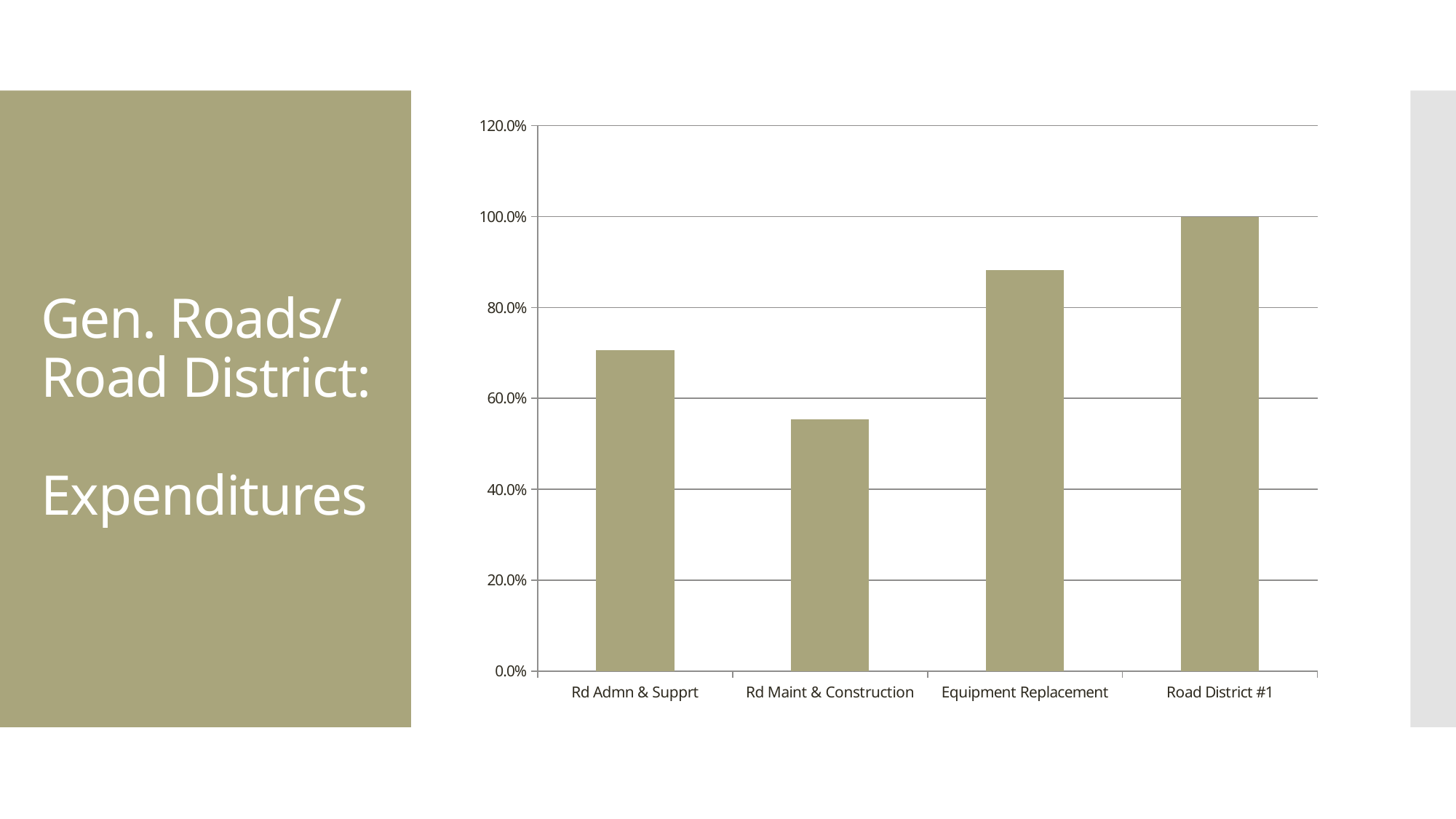
What is the highest value shown on the y axis of the chart? 120.0% How many categories are shown on the x axis of the chart? 4 Which is larger, the value for Equipment Replacement or the value for Rd Admn & Supprt? Equipment Replacement What is the value for Road District #1? 100.0% Is the value for Rd Admn & Supprt greater or less than 80.0%? less Is the value for Equipment Replacement greater or less than 80.0%? greater Which category has the highest value in the chart? Road District #1 Which category has the lowest value in the chart? Rd Maint & Construction Is the value for Rd Maint & Construction greater or less than 60.0%? less Which is larger, the value for Rd Maint & Construction or the value for Road District #1? Road District #1 What kind of chart is shown on the slide? bar chart